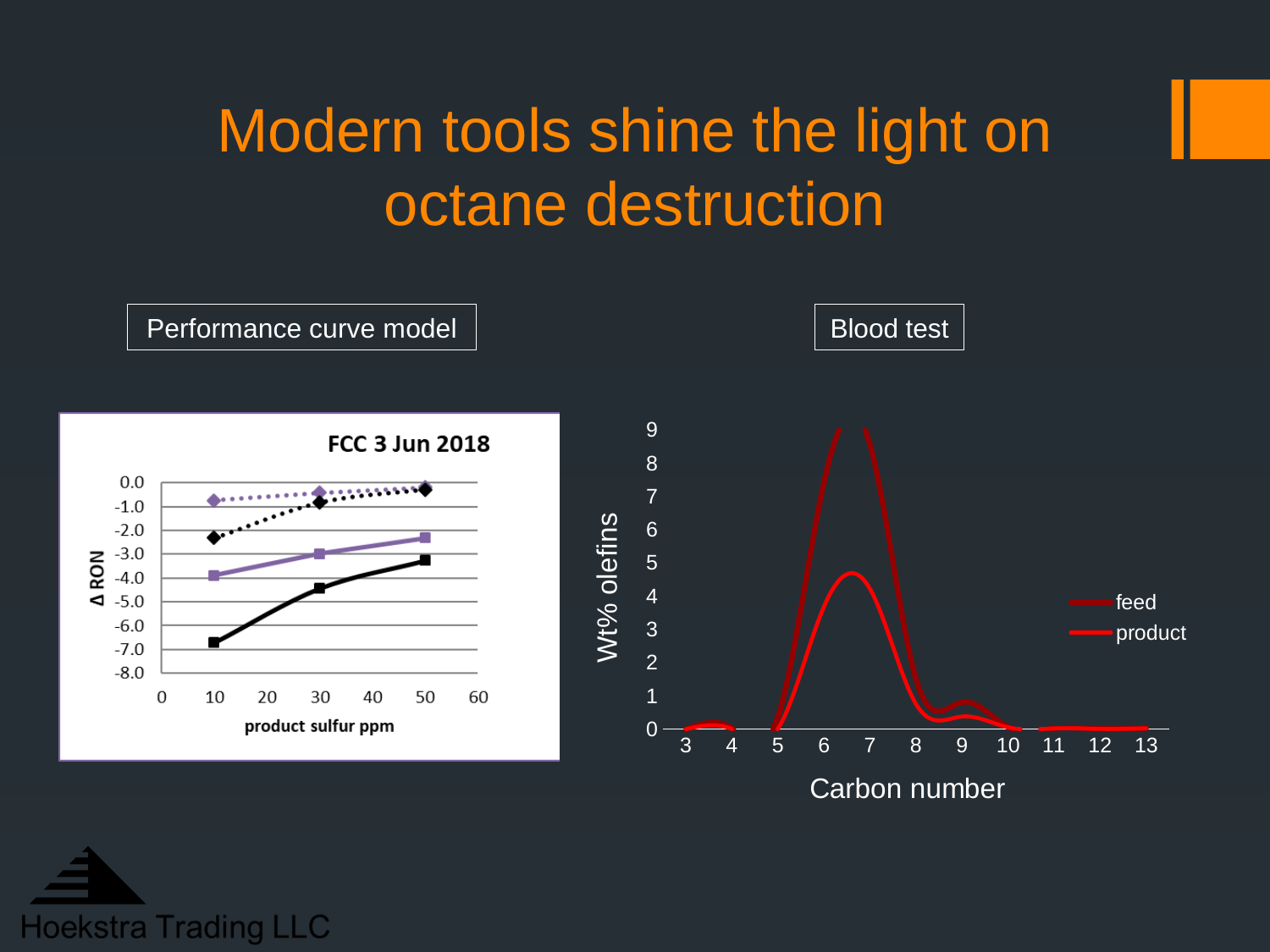
On the Blood test chart on the right, is the peak value of the feed series greater or less than 8? greater On the Blood test chart on the right, is the peak value of the product series greater or less than 4? greater On the FCC 3 Jun 2018 chart on the left, does the solid black line rise or fall as product sulfur ppm increases? rise On the FCC 3 Jun 2018 chart on the left, which line has the lowest value at 10 product sulfur ppm, the solid black line or the solid purple line? solid black line What is the title of the chart on the left? FCC 3 Jun 2018 On the Blood test chart on the right, what is the label of the y axis? Wt% olefins On the Blood test chart on the right, how many carbon numbers are marked along the x axis? 11 What kind of chart is the Blood test chart on the right? line chart On the Blood test chart on the right, how many series does the legend list? 2 On the Blood test chart on the right, what are the two series named in the legend? feed and product On the Blood test chart on the right, which series has the higher value at carbon number 7, feed or product? feed On the FCC 3 Jun 2018 chart on the left, is the value of the solid black line at 10 product sulfur ppm greater or less than -6.0? less